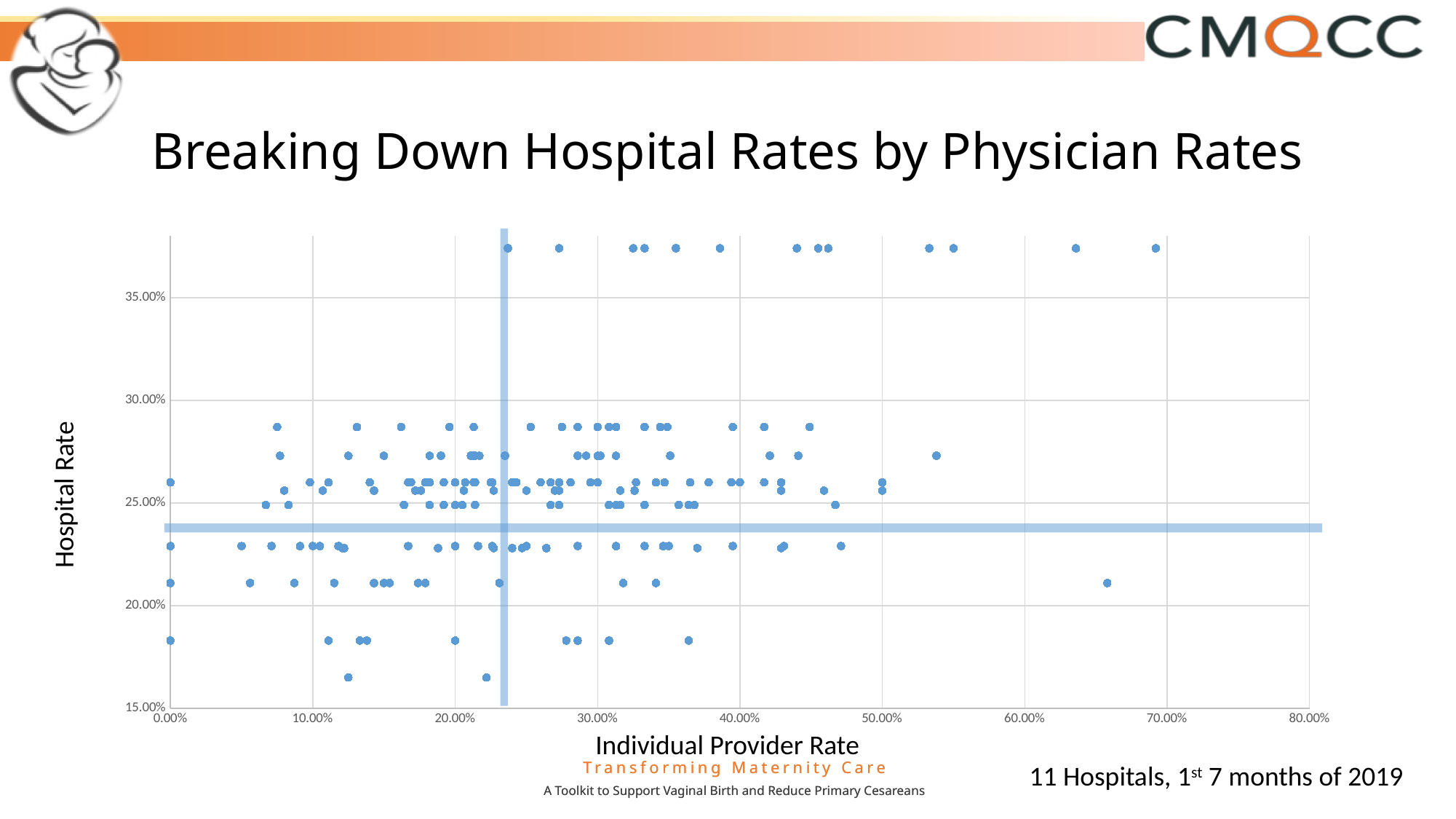
What is the title of the y axis of the chart? Hospital Rate Is the largest individual provider rate plotted on the chart greater or less than 60.00%? greater Is the horizontal reference line on the chart at a hospital rate greater or less than 25.00%? less Is the lowest hospital rate plotted on the chart greater or less than 20.00%? less What is the title of the x axis of the chart? Individual Provider Rate What kind of chart is shown on the slide? scatter plot